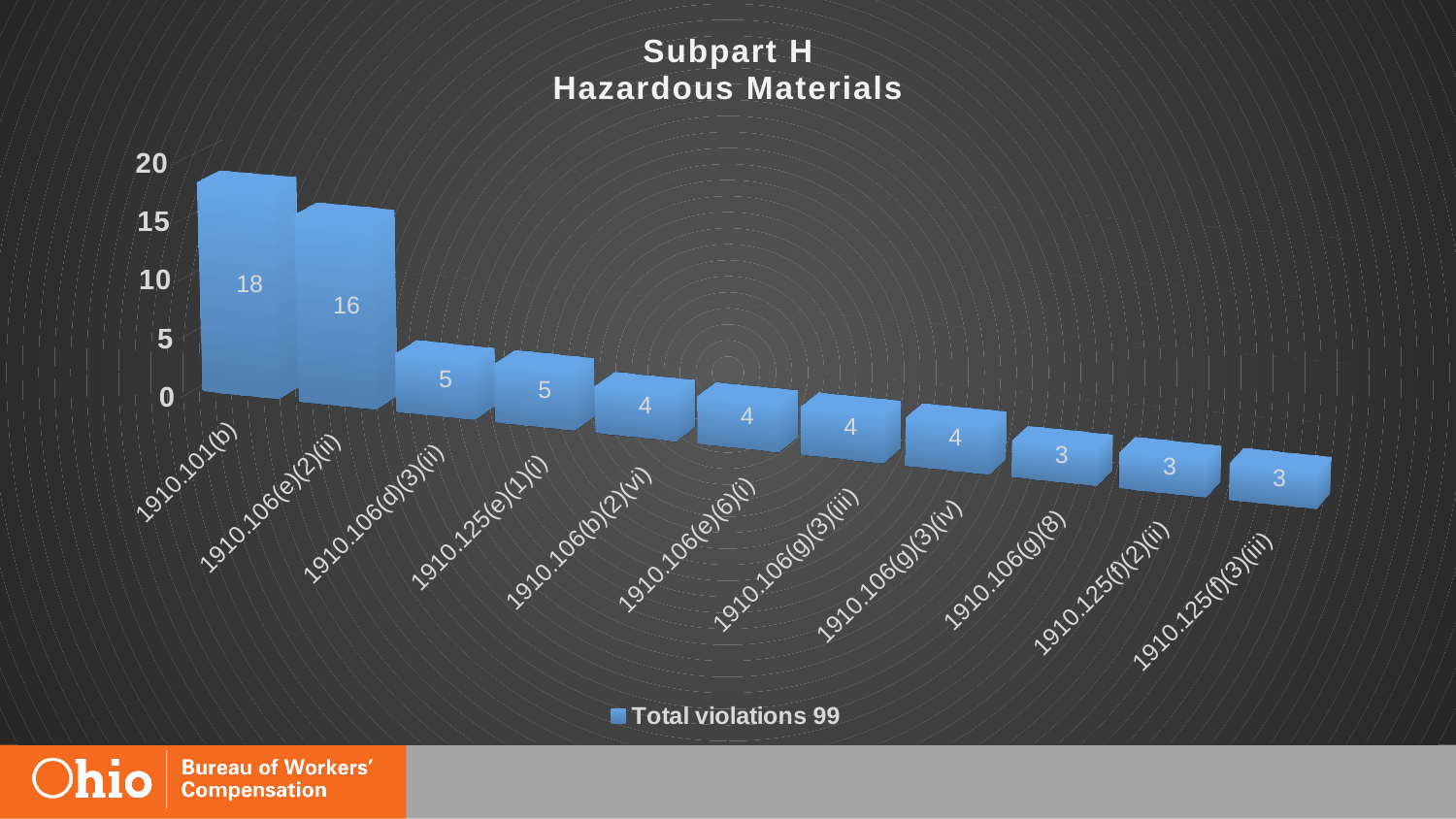
What is the value for 1910.106(e)(2)(ii)? 16 What is the value for 1910.101(b)? 18 What does the legend entry say? Total violations 99 What is the difference between the values for 1910.101(b) and 1910.106(e)(2)(ii)? 2 What is the value for 1910.106(d)(3)(ii)? 5 How many categories are shown on the chart? 11 Which category has the highest value? 1910.101(b) What is the value for 1910.106(g)(8)? 3 What is the title of the chart? Subpart H Hazardous Materials What kind of chart is shown on the slide? Bar chart What is the value for 1910.106(b)(2)(vi)? 4 Which is larger, the value for 1910.125(e)(1)(i) or the value for 1910.125(f)(3)(iii)? 1910.125(e)(1)(i)